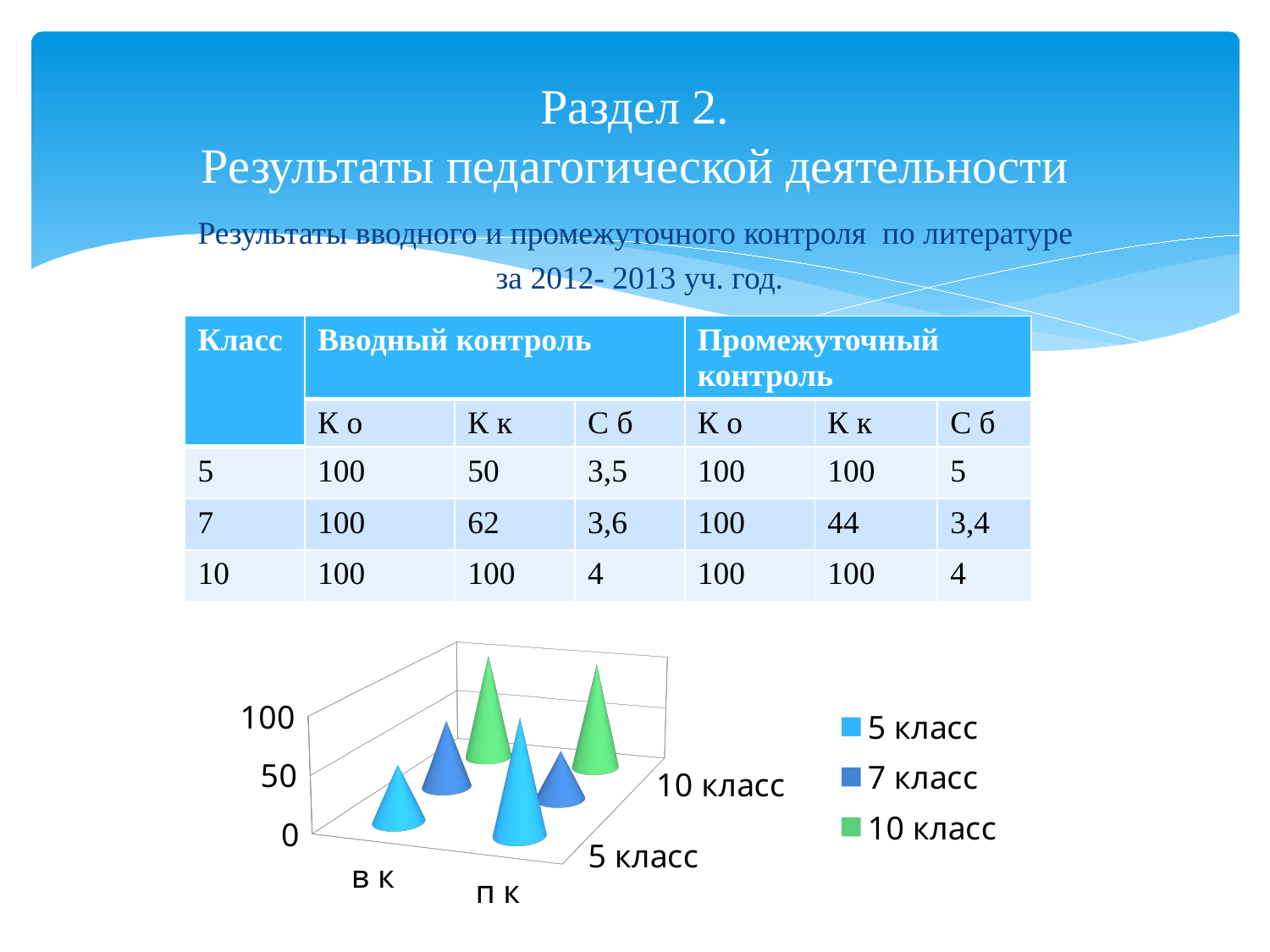
Which colour represents the series '10 класс' in the chart? green How many categories are shown along the x axis of the chart? 2 Which series has the tallest cone for the category 'в к'? 10 класс What kind of chart is shown at the bottom of the slide? bar chart For the category 'в к', which is larger: the value for '10 класс' or for '5 класс'? 10 класс Is the value for '10 класс' in the category 'п к' greater or less than 50? greater How many series does the chart legend list? 3 What are the category labels on the x axis of the chart? в к, п к Which series has the shortest cone for the category 'в к'? 5 класс For the series '5 класс', which category has the larger value: 'в к' or 'п к'? п к Is the value for '10 класс' in the category 'в к' greater or less than 50? greater